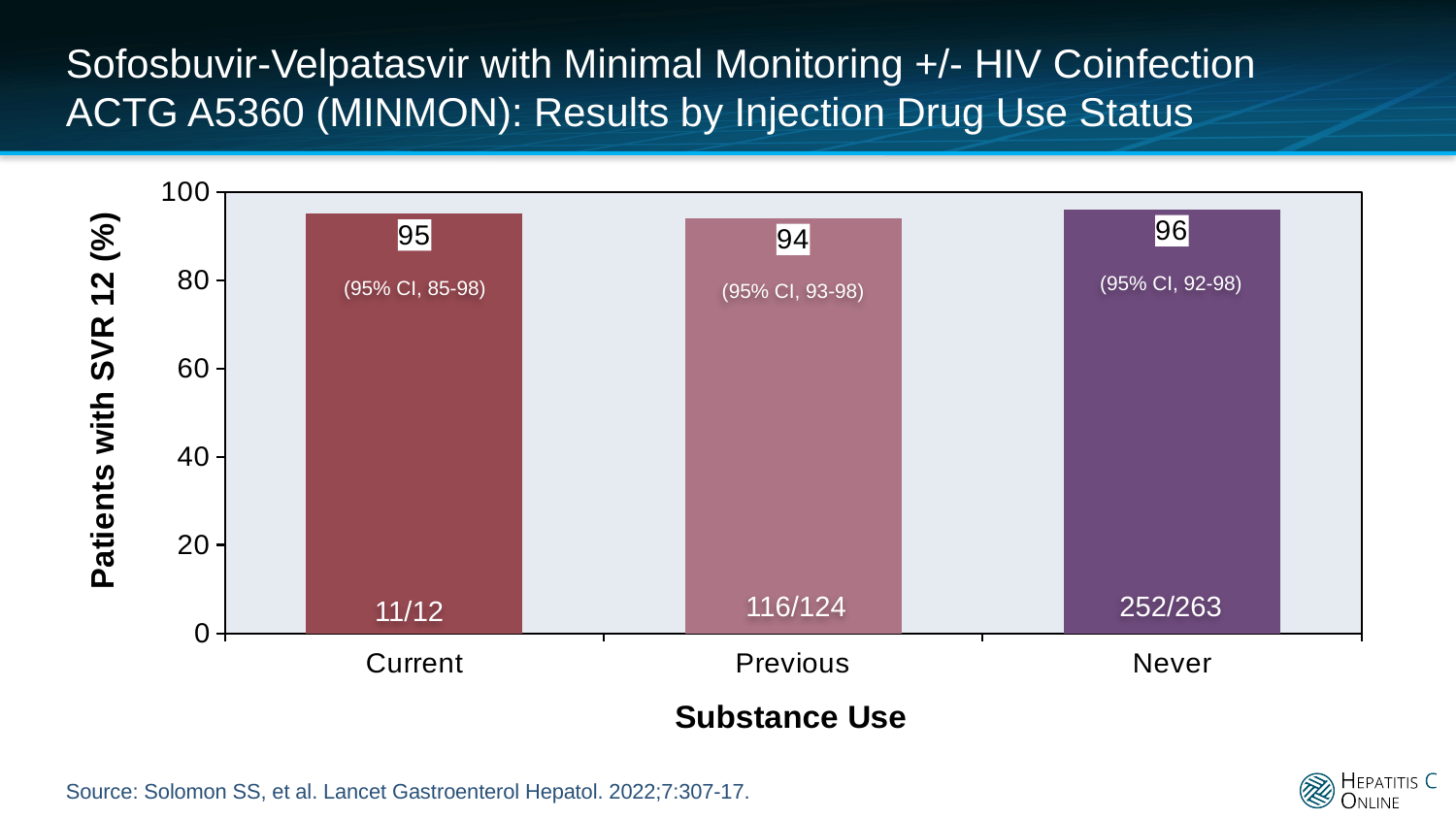
What is the difference in SVR 12 rate between the Never and Previous groups? 2 Which group has a higher SVR 12 rate, Current or Never? Never What is the SVR 12 rate for the Never substance use group? 96 How many substance use categories are shown on the x axis? 3 What is the SVR 12 rate for the Previous substance use group? 94 What is the SVR 12 rate for the Current substance use group? 95 What fraction of patients achieved SVR 12 in the Previous substance use group? 116/124 Which substance use group has the lowest SVR 12 rate? Previous Which substance use group has the highest SVR 12 rate? Never What is the 95% confidence interval shown for the Current substance use group? 85-98 What kind of chart is shown on the slide? Bar chart What is the label of the y axis? Patients with SVR 12 (%)